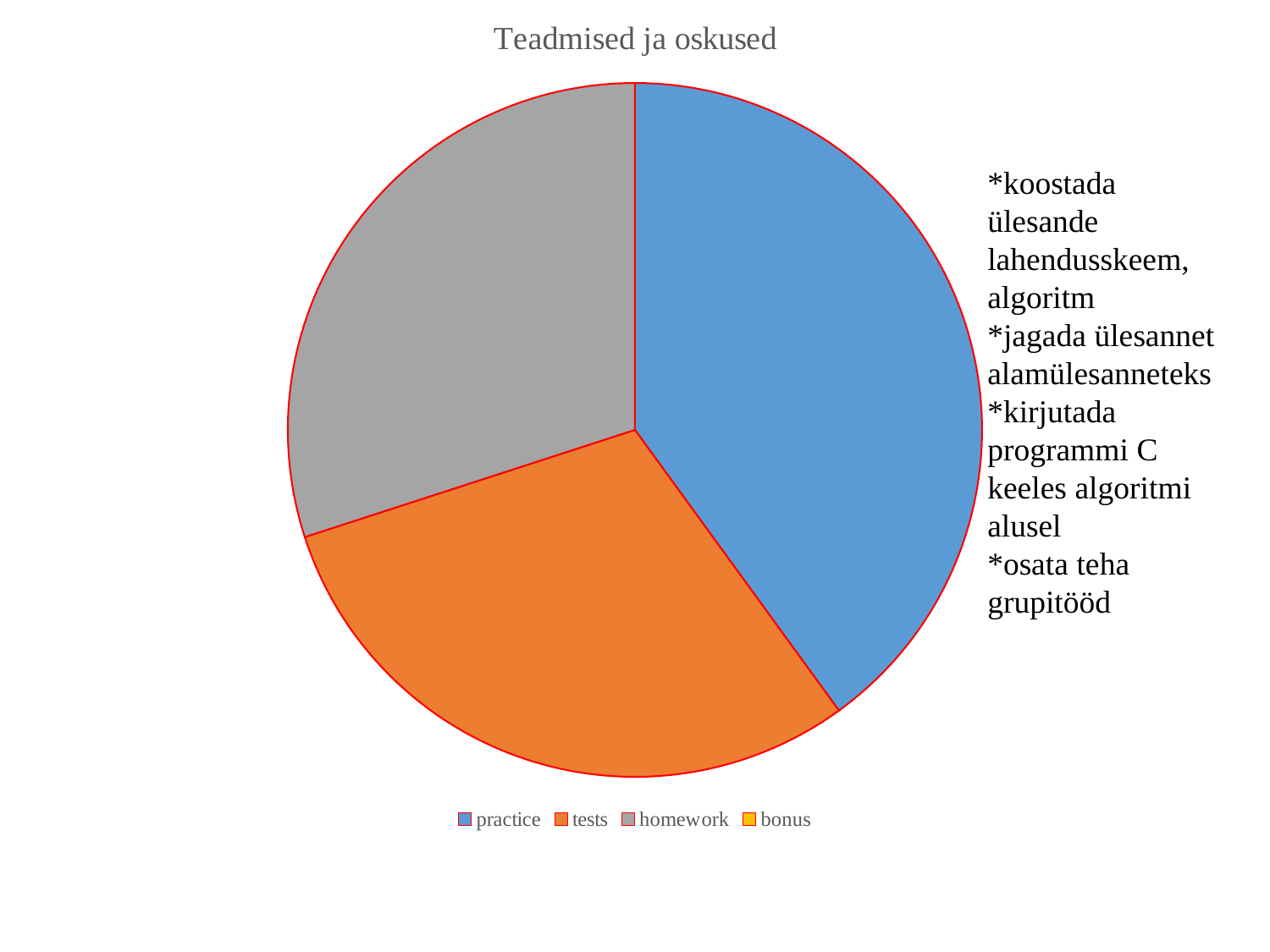
Which category has the largest slice of the pie? practice What is the title of the chart? Teadmised ja oskused Which colour represents the practice category in the pie chart? blue Which legend entry has no visible slice in the pie chart? bonus What kind of chart is shown on the slide? pie chart Which slice is larger, practice or tests? practice Which slice is larger, practice or homework? practice How many entries does the chart's legend list? 4 How many slices are visible in the pie chart? 3